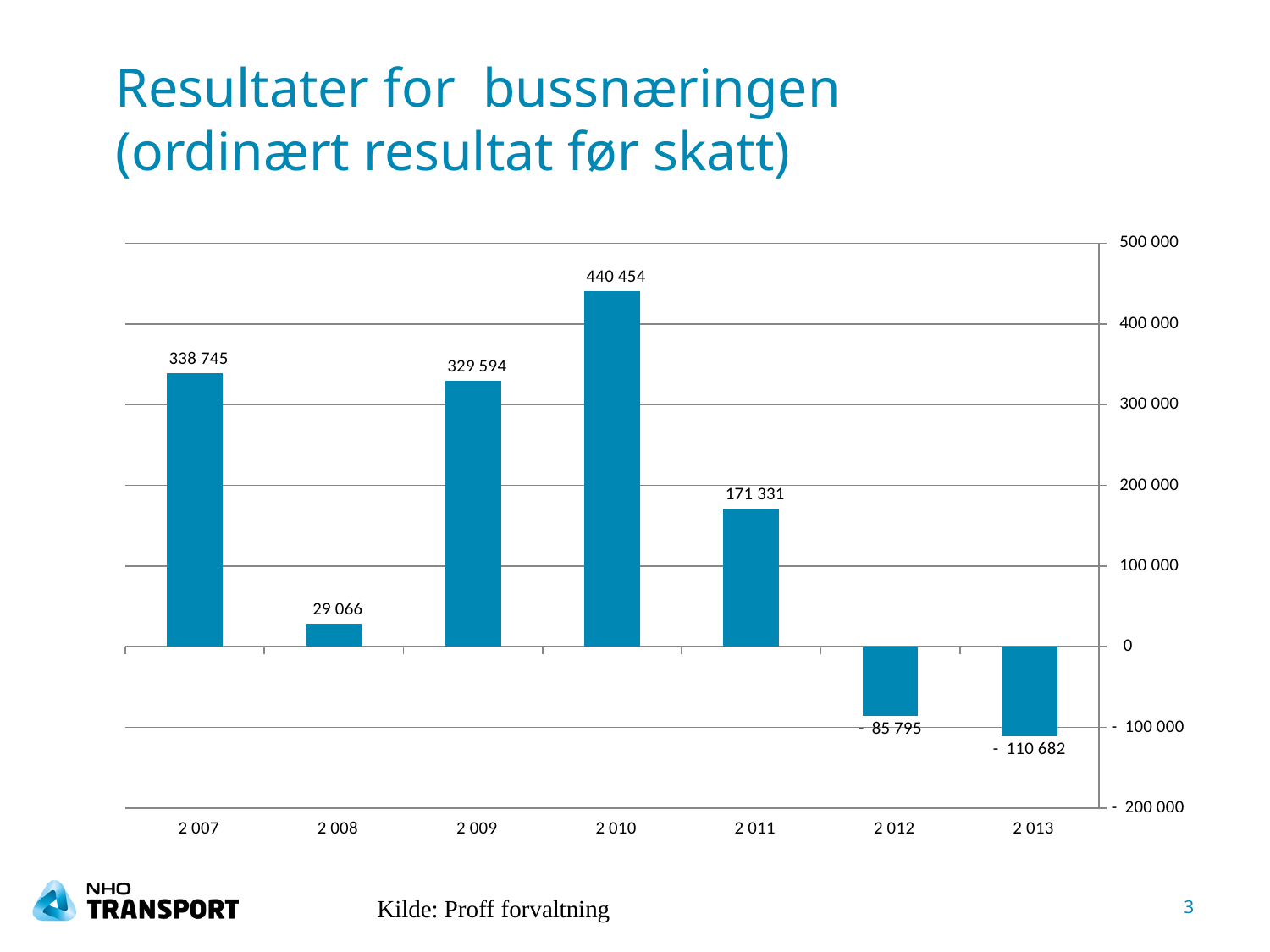
What is the difference between the values for 2 010 and 2 007? 101 709 Do the values rise or fall from 2 010 to 2 013? Fall What is the value for 2 013? - 110 682 Which is larger, the value for 2 007 or the value for 2 009? 2 007 How many years are shown on the x axis? 7 What is the difference between the values for 2 011 and 2 008? 142 265 What is the value for 2 008? 29 066 What is the value for 2 010? 440 454 What kind of chart is shown on the slide? Bar chart Which year has the highest value? 2 010 Which year has the lowest value? 2 013 What is the value for 2 011? 171 331